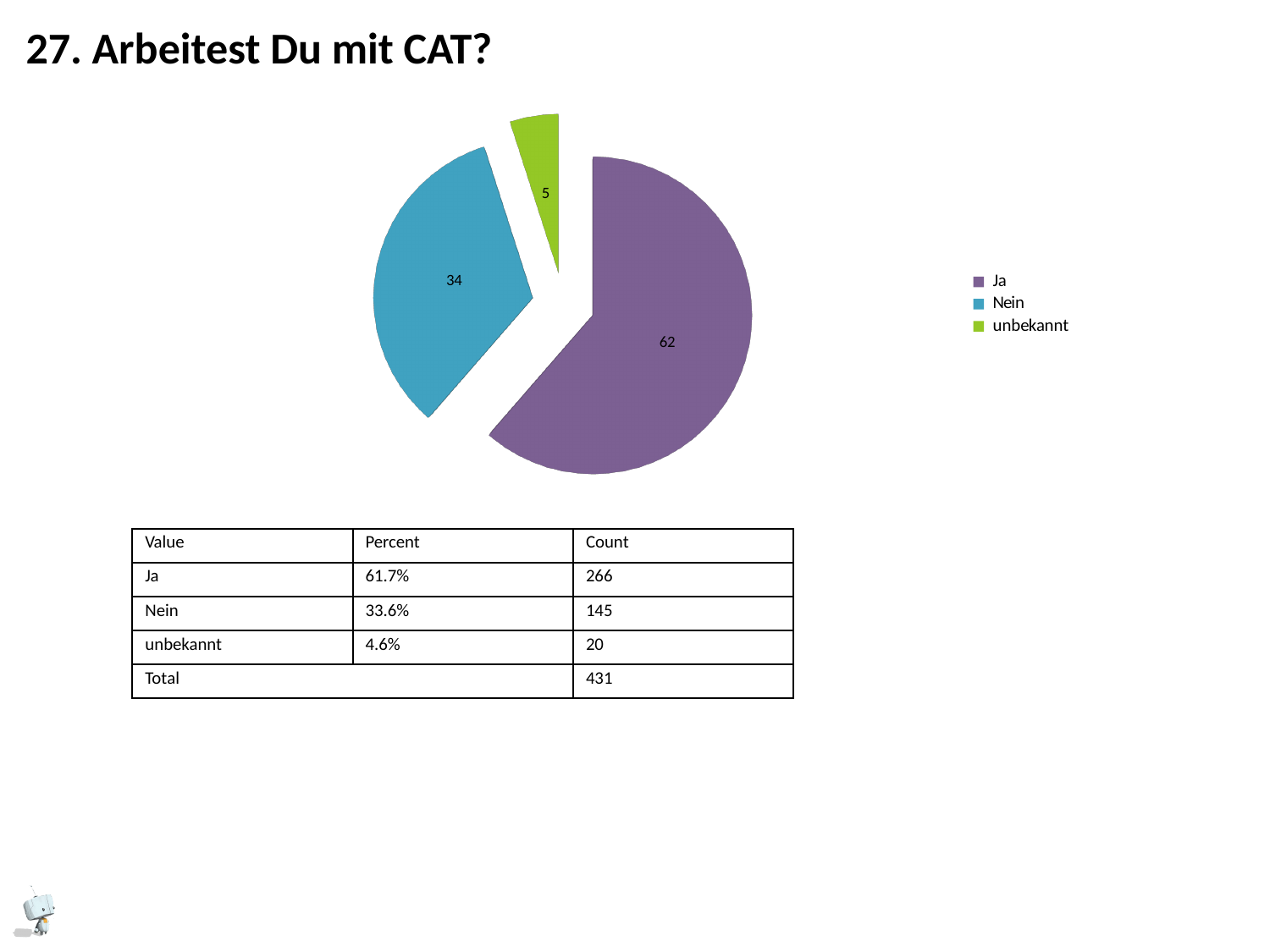
How many slices does the pie chart have? 3 What is the data label on the unbekannt slice of the pie chart? 5 What type of chart is shown on the slide? pie chart Which slice of the pie chart is the largest? Ja What colour is the Ja slice in the pie chart? purple What is the data label on the Nein slice of the pie chart? 34 Which slice is larger in the pie chart, Nein or unbekannt? Nein What is the data label on the Ja slice of the pie chart? 62 What is the title of the slide containing the pie chart? 27. Arbeitest Du mit CAT? How many entries does the legend of the pie chart list? 3 Which slice of the pie chart is the smallest? unbekannt What is the difference between the data labels of the Ja and Nein slices in the pie chart? 28